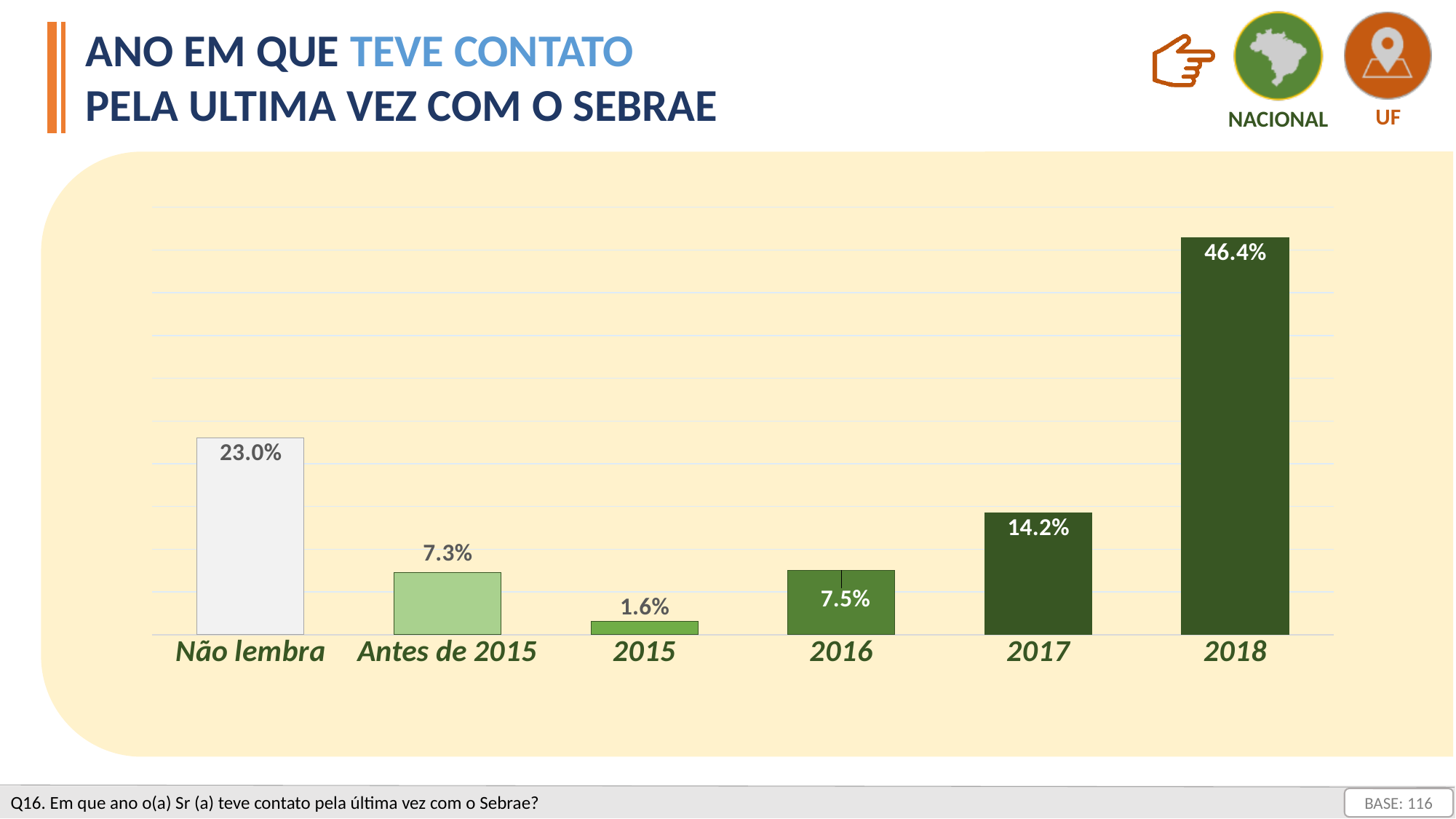
What is the value for Antes de 2015? 7.3% What is the value for 2018? 46.4% Which category has the lowest value? 2015 What is the value for 2017? 14.2% What is the difference between the values for Não lembra and 2016? 15.5% What is the value for Não lembra? 23.0% What is the value for 2015? 1.6% Which category has the highest value? 2018 How many categories are shown in the chart? 6 Which is larger, the value for Não lembra or the value for 2017? Não lembra What is the difference between the values for 2018 and 2017? 32.2% What kind of chart is shown on the slide? Bar chart